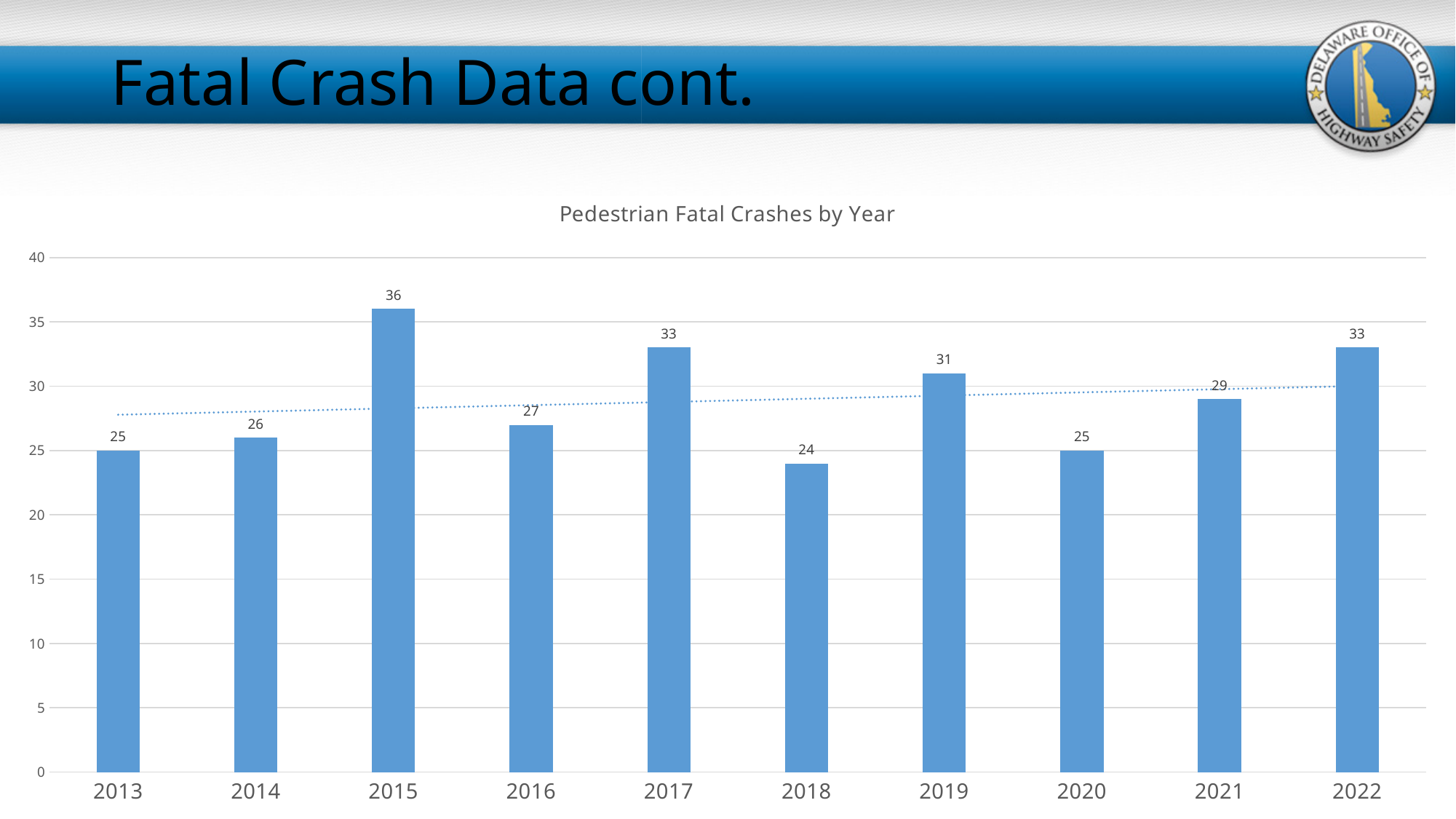
What is the title of the chart? Pedestrian Fatal Crashes by Year Is the value for 2017 greater or less than 30? greater Which is larger, the value for 2019 or the value for 2016? 2019 What is the difference between the values for 2022 and 2021? 4 What is the value for 2021? 29 What is the value for 2015? 36 How many years are shown on the x axis? 10 What is the difference between the values for 2015 and 2018? 12 Which year has the lowest number of pedestrian fatal crashes? 2018 Which year has the highest number of pedestrian fatal crashes? 2015 What kind of chart is shown on the slide? bar chart What is the value for 2018? 24